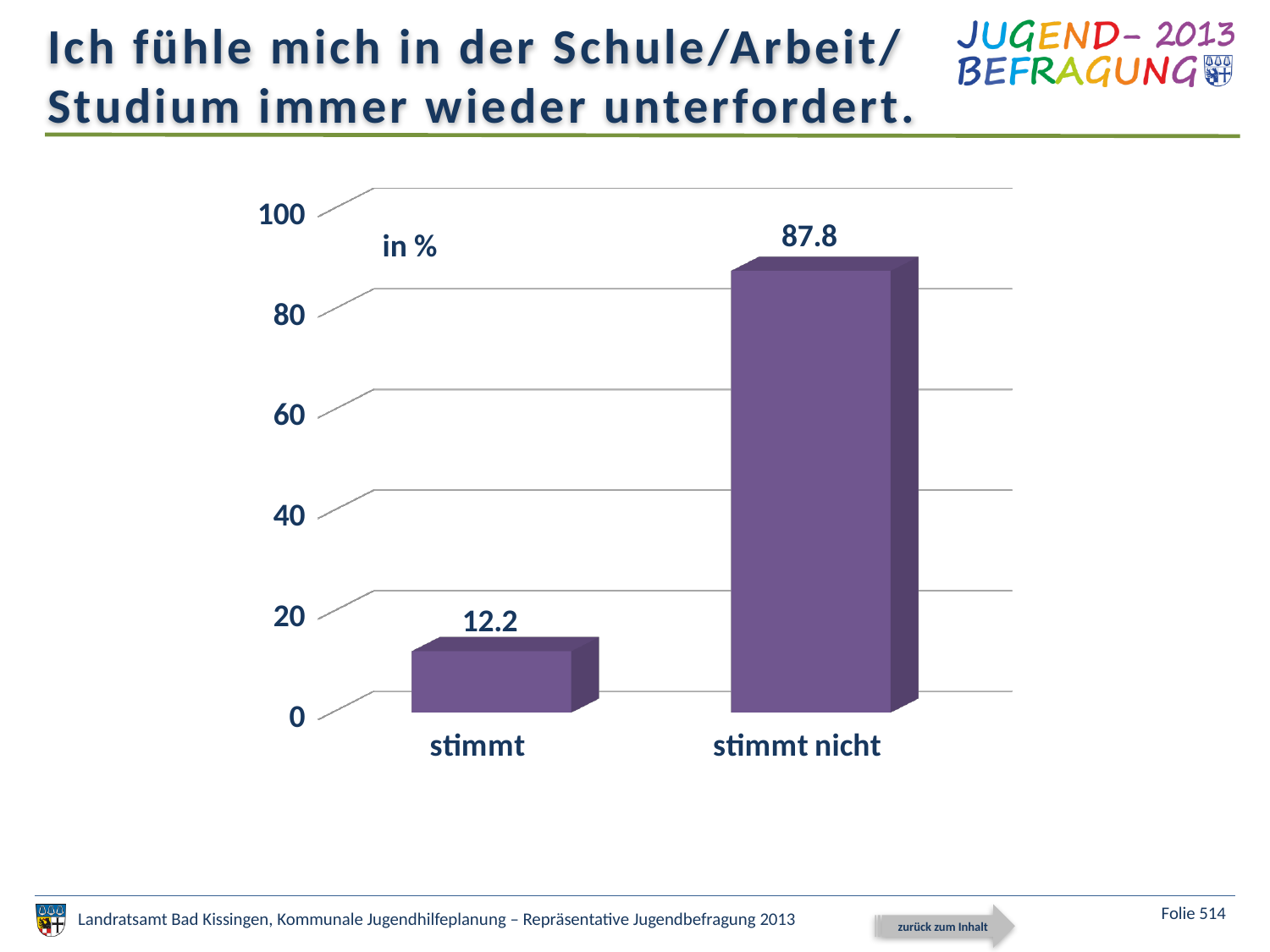
What kind of chart is shown on the slide? bar chart What is the total of the two plotted values? 100 Which category has the highest value? stimmt nicht What is the difference between the values for "stimmt nicht" and "stimmt"? 75.6 Is the value for "stimmt nicht" greater or less than 80? greater What is the value for "stimmt nicht"? 87.8 Which is larger, the value for "stimmt" or the value for "stimmt nicht"? stimmt nicht Is the value for "stimmt" greater or less than 20? less How many categories are shown on the x axis? 2 Which category has the lowest value? stimmt What is the value for "stimmt"? 12.2 What unit label is shown inside the chart area? in %